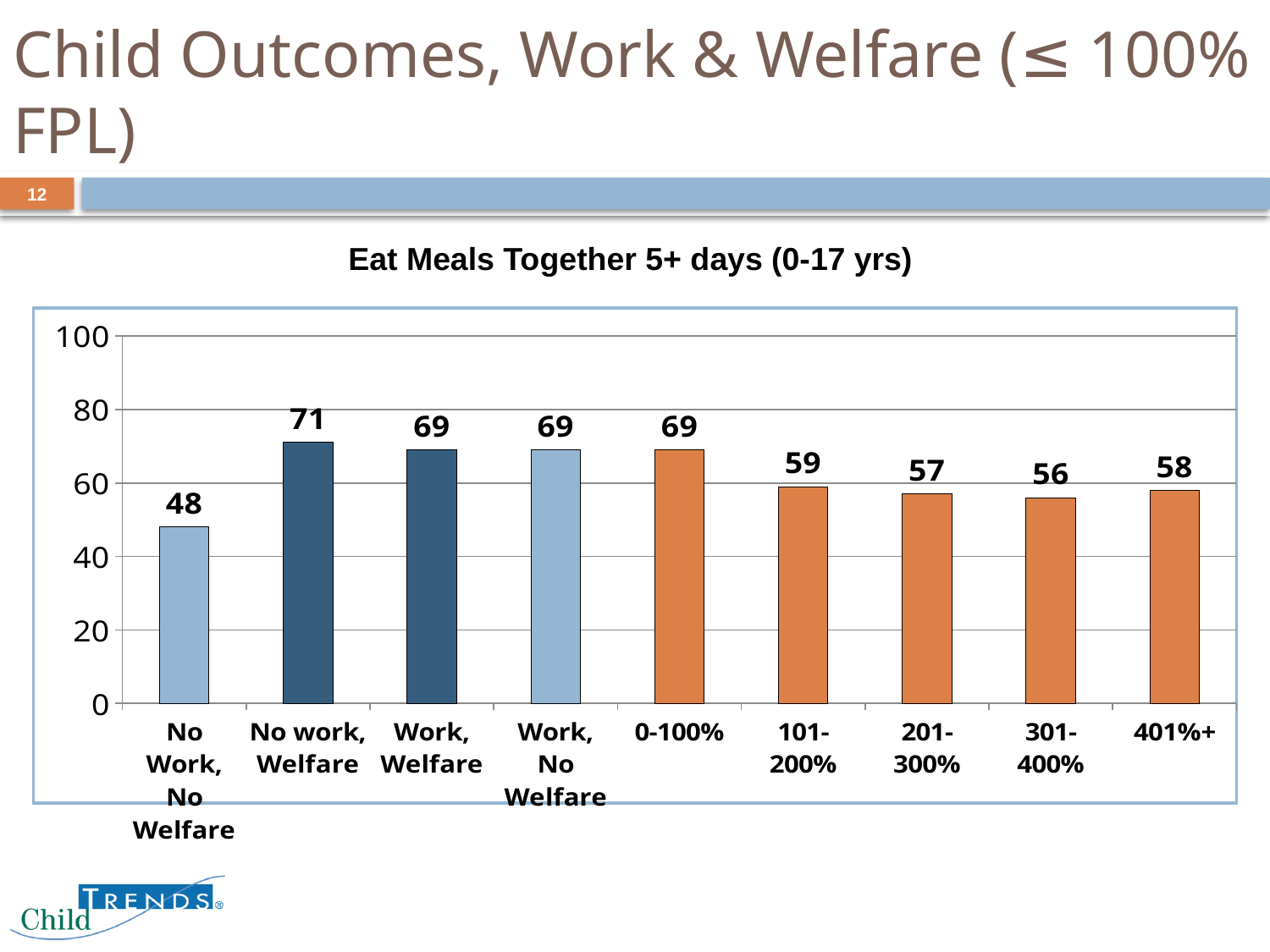
What is the difference between the values for '0-100%' and '301-400%'? 13 What is the difference between the values for 'No work, Welfare' and 'No Work, No Welfare'? 23 What is the value for the 'No Work, No Welfare' category? 48 How many categories are shown on the x axis? 9 What kind of chart is shown on the slide? bar chart What is the title of the chart? Eat Meals Together 5+ days (0-17 yrs) Is the value for '301-400%' greater or less than 60? less Which category has the lowest value? No Work, No Welfare Which is larger, the value for 'Work, Welfare' or the value for '201-300%'? Work, Welfare Which category has the highest value? No work, Welfare What is the value for the '401%+' category? 58 What is the value for the '101-200%' category? 59